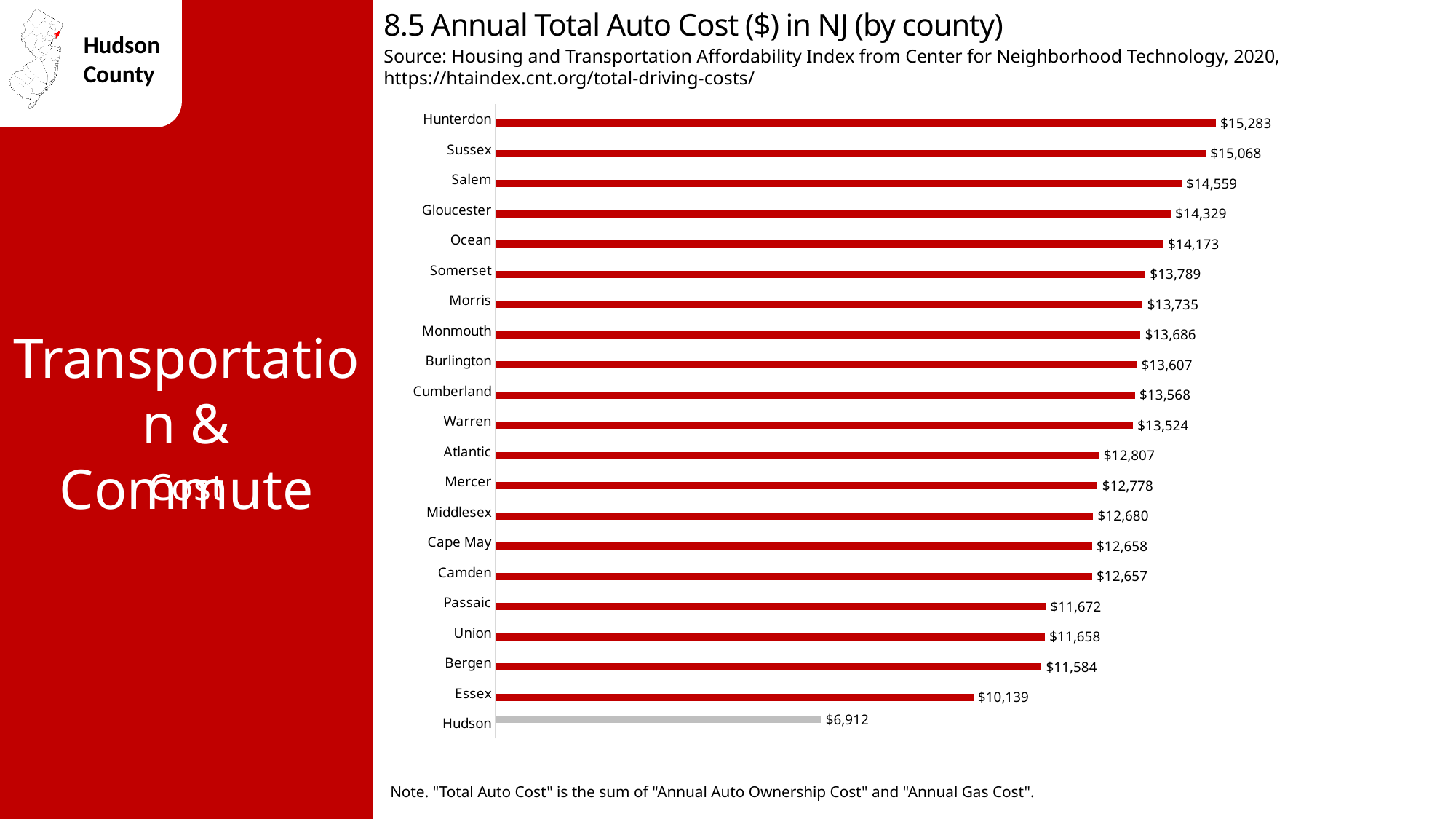
Which county has the highest annual total auto cost? Hunterdon Which county has the lowest annual total auto cost? Hudson Which county's bar is shown in a different colour (grey) from the others? Hudson What type of chart is used to show annual total auto cost by county? Bar chart How many counties are shown in the chart? 21 What is the annual total auto cost for Bergen County? $11,584 What is the difference in annual total auto cost between Essex and Hudson? $3,227 Which county has a higher annual total auto cost, Sussex or Salem? Sussex What is the annual total auto cost for Hudson County? $6,912 Which county has a higher annual total auto cost, Passaic or Essex? Passaic What is the difference in annual total auto cost between Hunterdon and Hudson? $8,371 What is the annual total auto cost for Hunterdon County? $15,283